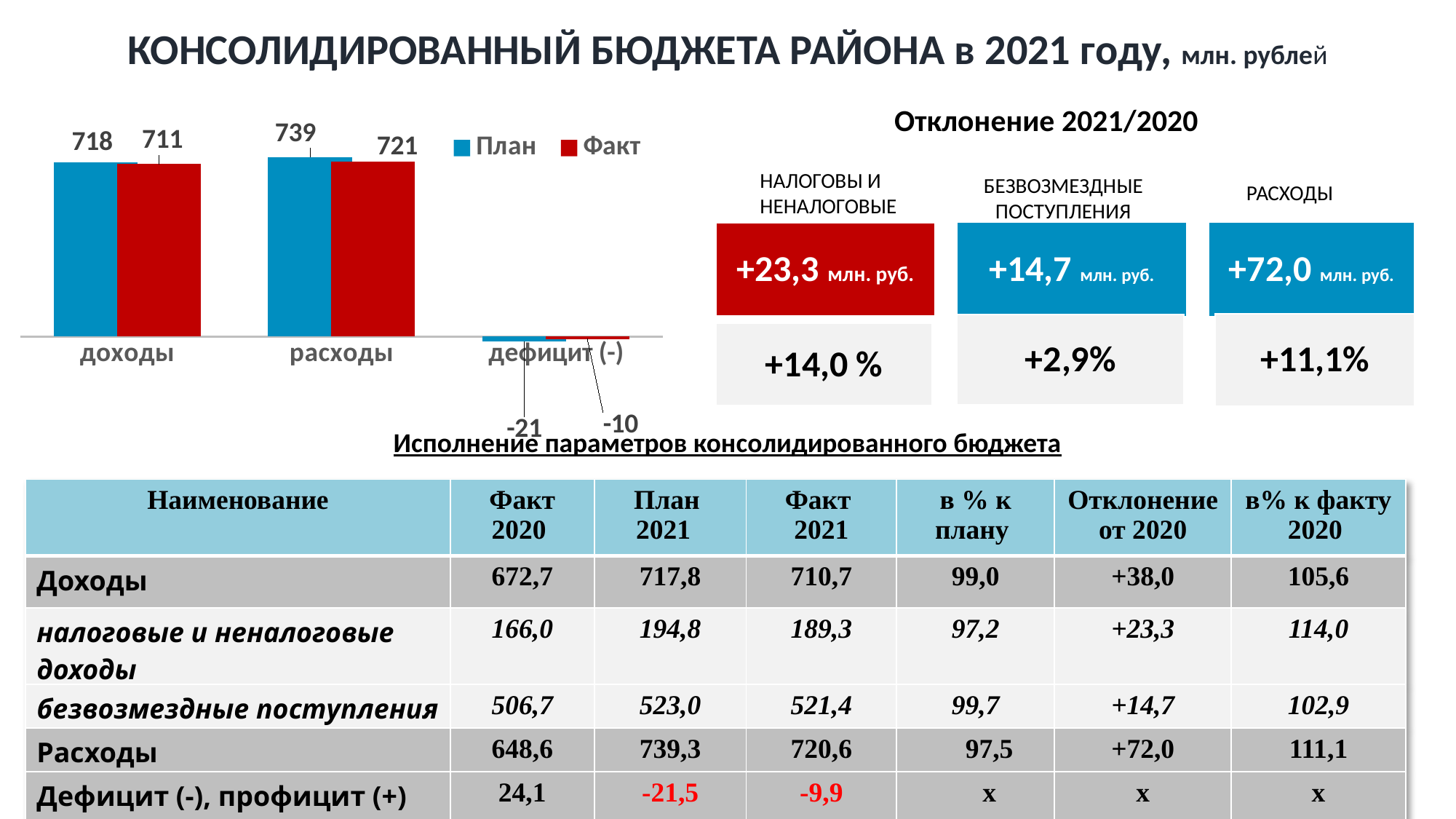
In the bar chart, what is the Факт value for доходы? 711 How many series does the bar chart's legend list? 2 In the bar chart, what is the Факт value for дефицит (-)? -10 In the bar chart, what is the План value for доходы? 718 In the bar chart, which category has the lowest Факт value? дефицит (-) In the bar chart, what is the difference between the План and Факт values for расходы? 18 What type of chart is shown on the left of the slide? bar chart In the bar chart, what is the Факт value for расходы? 721 In the bar chart, which category has the highest План value? расходы In the bar chart, what is the План value for дефицит (-)? -21 In the bar chart, what is the План value for расходы? 739 In the bar chart, which is larger for доходы: План or Факт? План